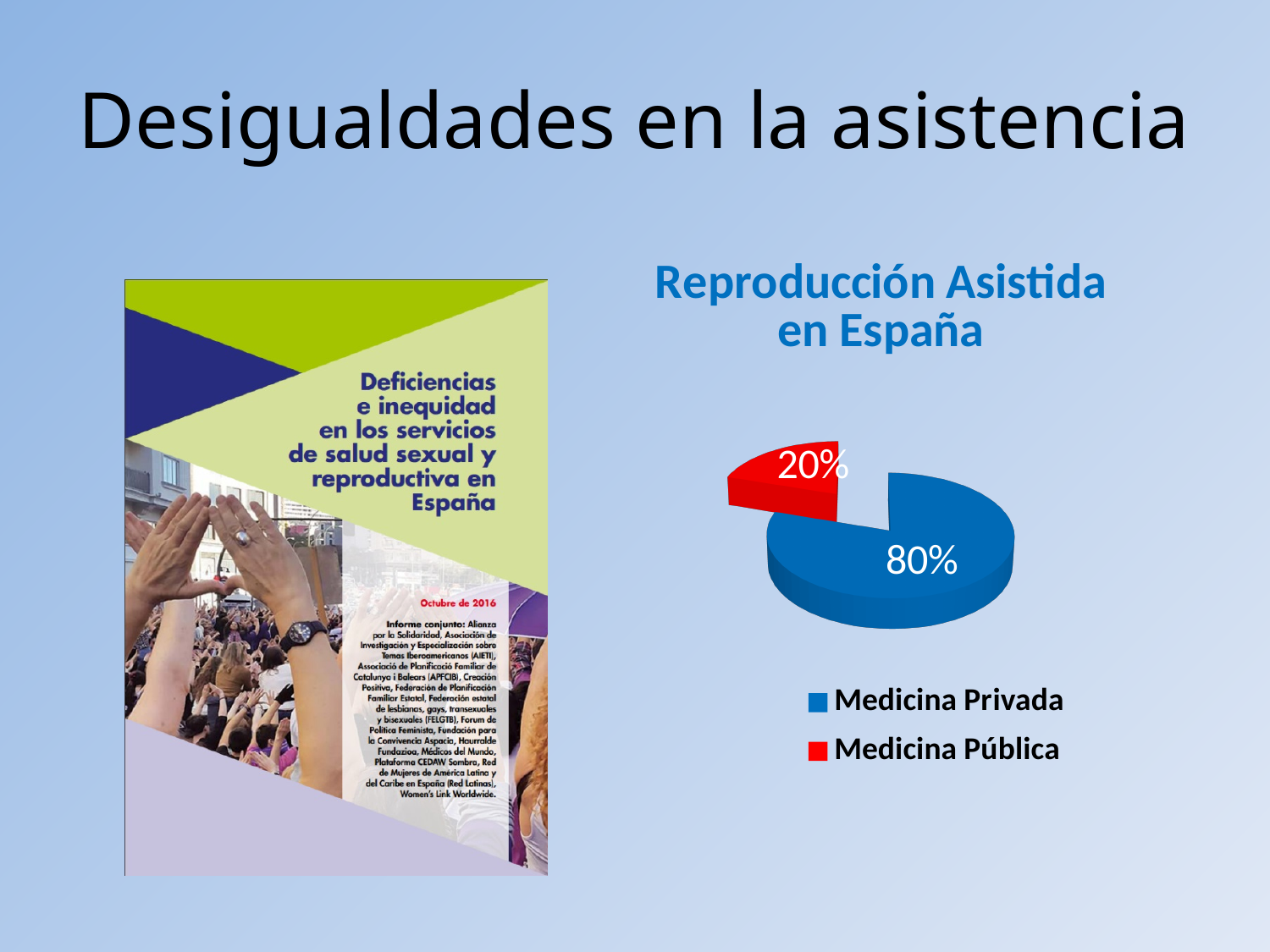
How many slices does the pie chart have? 2 Which category has the smallest share of the pie? Medicina Pública Which category has the largest share of the pie? Medicina Privada What type of chart is shown on the slide? Pie chart Which is larger, the share for Medicina Privada or for Medicina Pública? Medicina Privada What share of the pie does Medicina Privada represent? 80% What share of the pie does Medicina Pública represent? 20% What is the difference in percentage points between Medicina Privada and Medicina Pública? 60 How many entries does the legend list? 2 What is the title of the chart? Reproducción Asistida en España What colour is the slice for Medicina Pública? Red